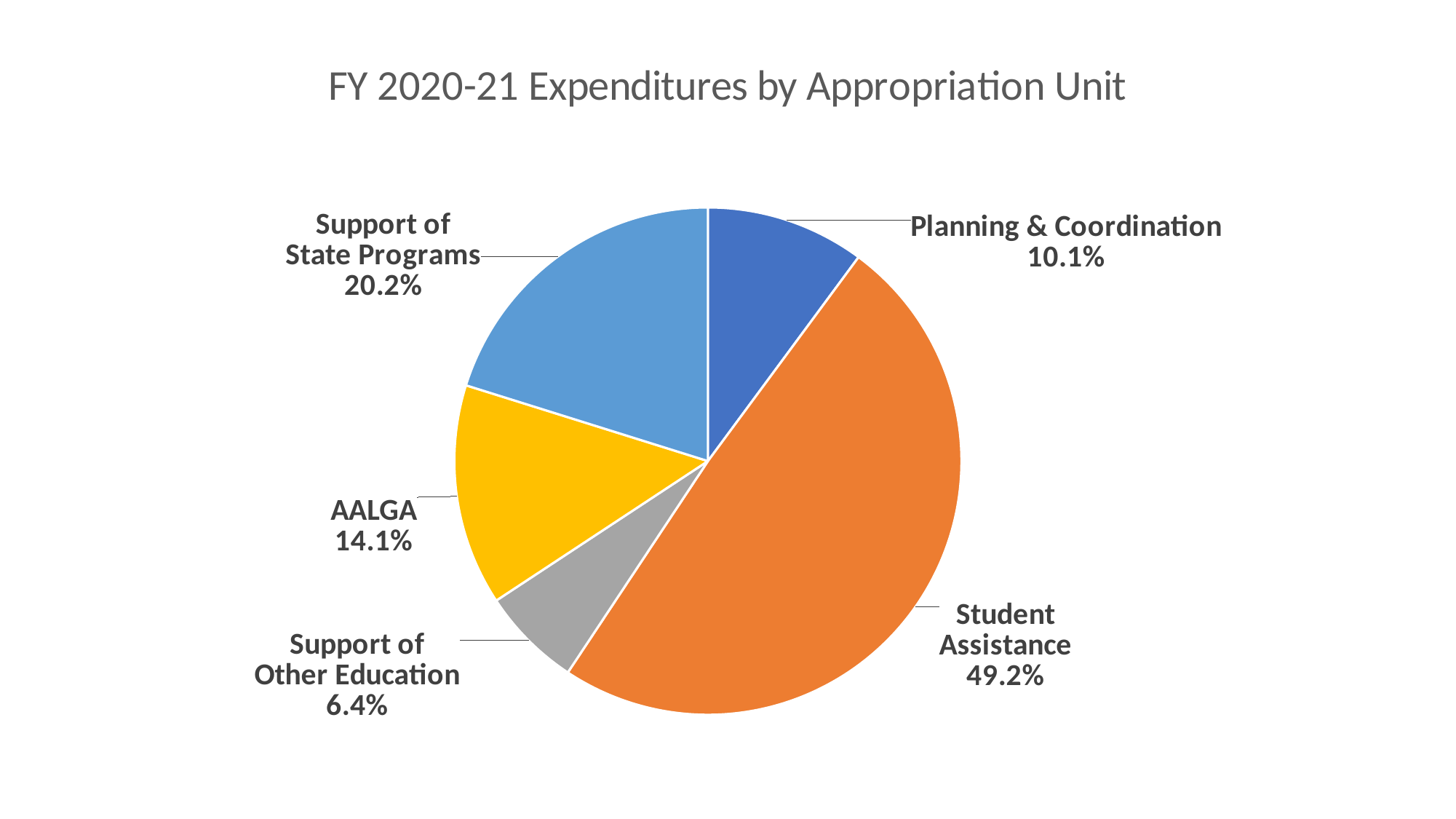
What share of expenditures is AALGA? 14.1% What is the difference in percentage points between Support of State Programs and AALGA? 6.1 What share of expenditures is Student Assistance? 49.2% How many appropriation units are shown in the pie chart? 5 What is the title of the chart? FY 2020-21 Expenditures by Appropriation Unit What share of expenditures is Support of State Programs? 20.2% Which appropriation unit has the largest share of expenditures? Student Assistance Which is larger, the share for AALGA or the share for Planning & Coordination? AALGA What kind of chart is shown on the slide? pie chart Which appropriation unit has the smallest share of expenditures? Support of Other Education